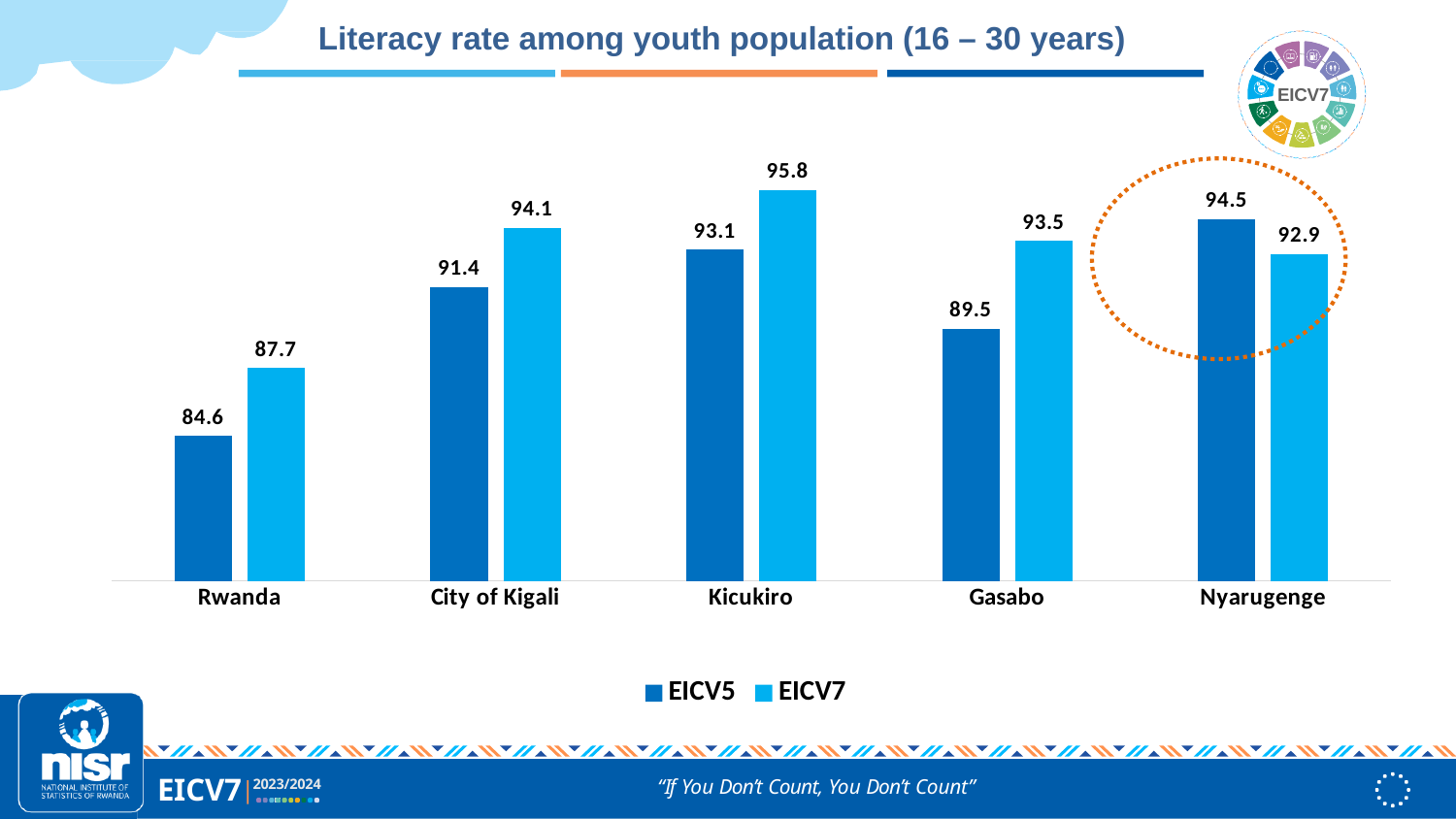
What is the EICV5 literacy rate for Nyarugenge? 94.5 What is the difference between the EICV7 and EICV5 literacy rates for Gasabo? 4.0 What is the EICV5 literacy rate for Gasabo? 89.5 Which is larger for Nyarugenge, the EICV5 value or the EICV7 value? EICV5 Which category has the lowest EICV5 literacy rate? Rwanda What kind of chart is shown on the slide? Bar chart How many categories are shown on the x axis? 5 Which category has the highest EICV7 literacy rate? Kicukiro What is the title of the chart? Literacy rate among youth population (16 – 30 years) How many series does the legend list? 2 What is the difference between the EICV7 and EICV5 literacy rates for Rwanda? 3.1 What is the EICV7 literacy rate for Rwanda? 87.7